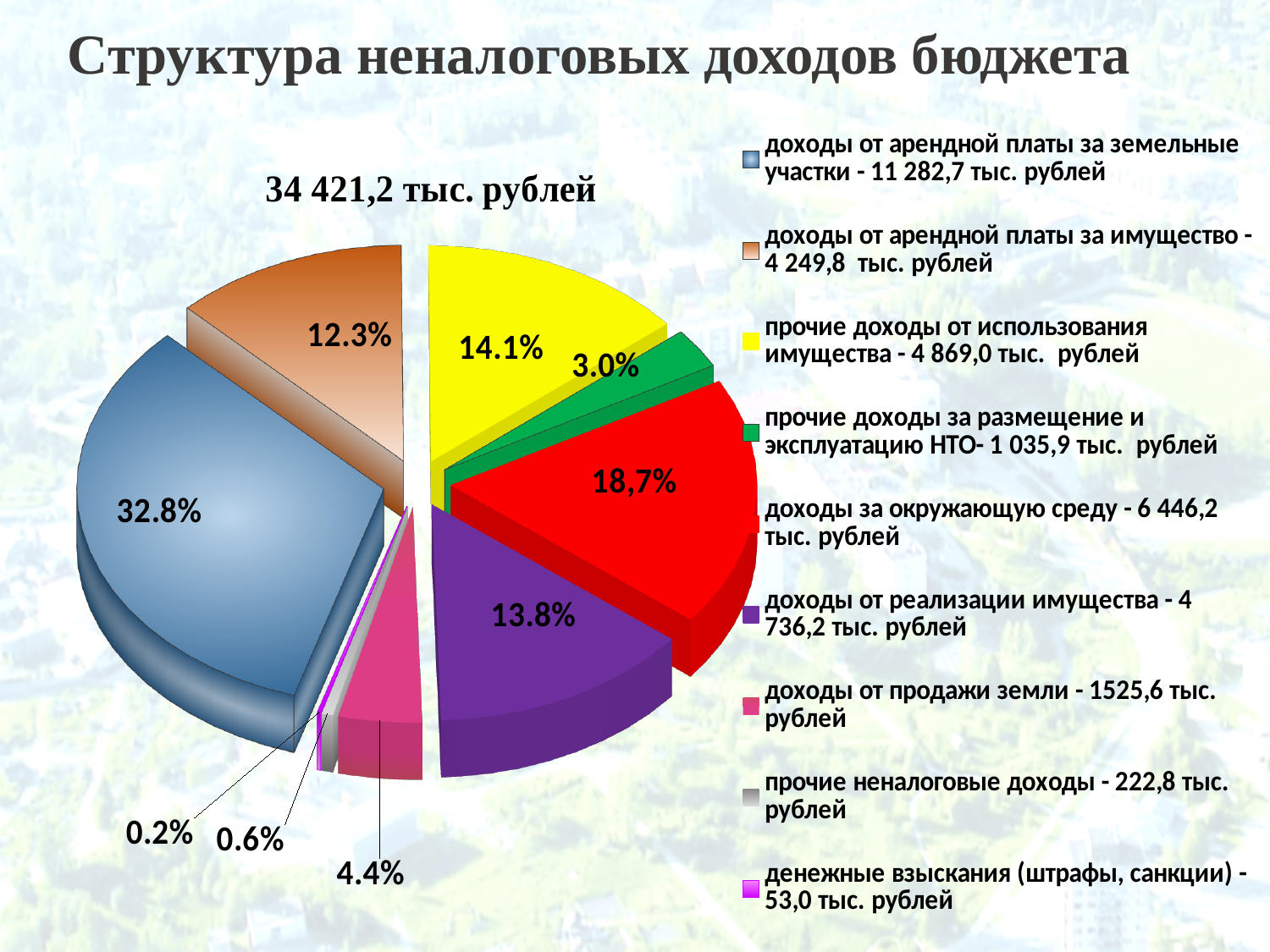
What percentage share is shown for доходы за окружающую среду? 18,7% Which category has the largest share of the pie? доходы от арендной платы за земельные участки Which category has the smallest share of the pie? денежные взыскания (штрафы, санкции) What total amount is printed above the pie chart? 34 421,2 тыс. рублей How many slices does the pie chart have? 9 Which has a larger share: прочие доходы от использования имущества or доходы от реализации имущества? прочие доходы от использования имущества What percentage share is shown for доходы от реализации имущества? 13.8% What is the difference in percentage points between the share for доходы от арендной платы за земельные участки (32.8%) and доходы от арендной платы за имущество (12.3%)? 20.5 What percentage share is shown for прочие доходы за размещение и эксплуатацию НТО? 3.0% What kind of chart is shown on the slide? pie chart What value in тыс. рублей does the legend give for доходы от продажи земли? 1525,6 тыс. рублей What value in тыс. рублей does the legend give for прочие доходы от использования имущества? 4 869,0 тыс. рублей